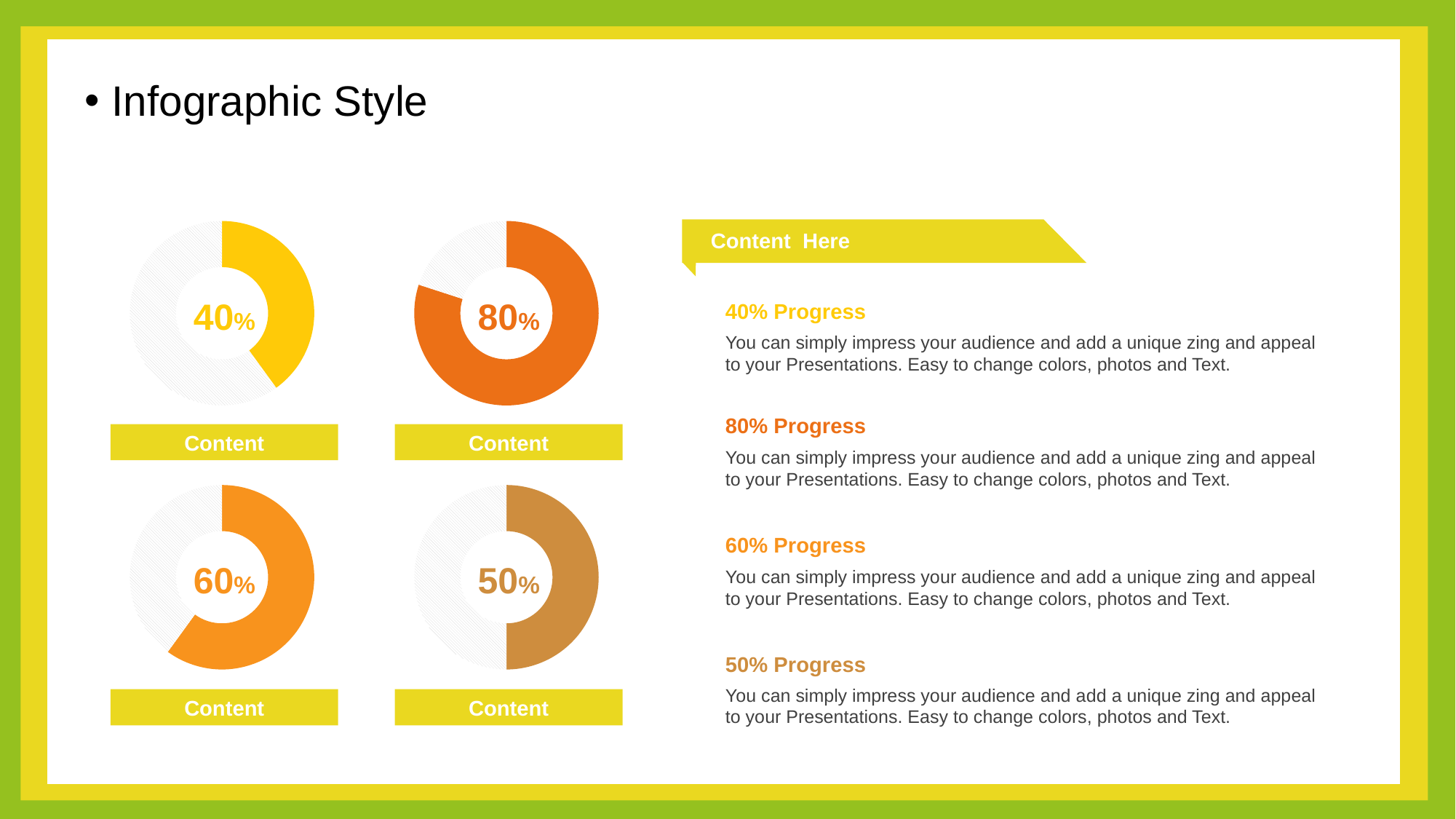
What value is shown in the centre of the bottom-right donut chart? 50% Which of the four donut charts shows the highest percentage? The top-right chart (80%) What value is shown in the centre of the top-right donut chart? 80% What value is shown in the centre of the top-left donut chart? 40% How many donut charts are shown on the slide? 4 What colour is the filled portion of the top-right donut chart? Orange What value is shown in the centre of the bottom-left donut chart? 60% What is the difference between the percentage in the top-right donut chart and the percentage in the top-left donut chart? 40% Which of the four donut charts shows the lowest percentage? The top-left chart (40%) What type of chart is used to display the percentages on the slide? Donut chart Which shows a larger percentage, the bottom-left donut chart or the bottom-right donut chart? The bottom-left chart (60%) What is the difference between the percentage in the bottom-left donut chart and the percentage in the bottom-right donut chart? 10%